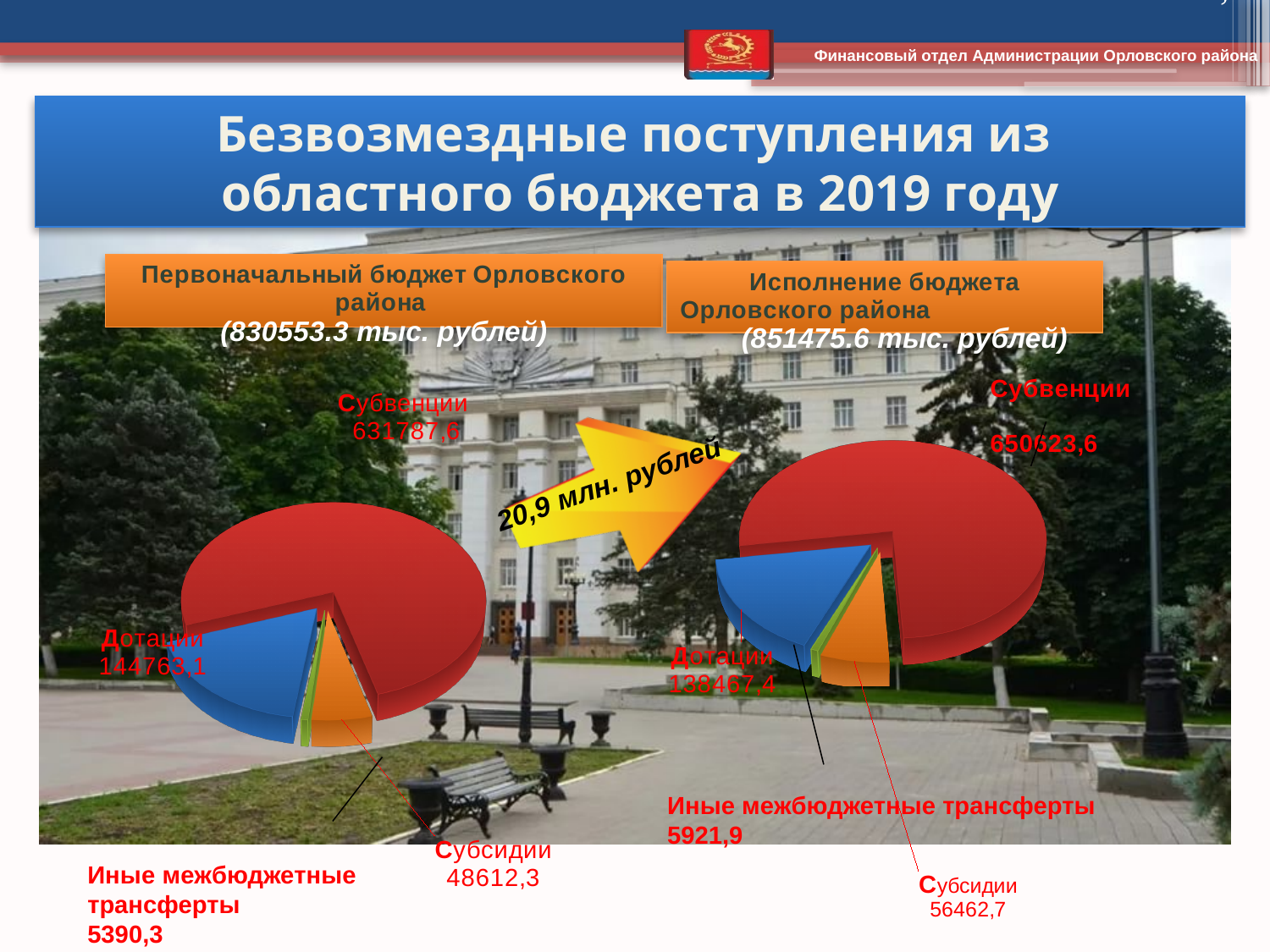
In the right chart (Исполнение бюджета Орловского района), what is the value for Иные межбюджетные трансферты? 5921,9 In the left chart (Первоначальный бюджет Орловского района), what is the value for Субсидии? 48612,3 In the right chart (Исполнение бюджета Орловского района), which category has the largest slice? Субвенции What type of chart is used on the left for the initial budget of Orlovsky district? Pie chart In the left chart (Первоначальный бюджет Орловского района), what is the value for Субвенции? 631787,6 What total amount is shown in the header of the right chart (Исполнение бюджета Орловского района)? 851475.6 тыс. рублей In the left chart (Первоначальный бюджет Орловского района), which category has the smallest value? Иные межбюджетные трансферты In the left chart (Первоначальный бюджет Орловского района), what is the value for Дотации? 144763,1 Which is larger: Дотации in the left chart (Первоначальный бюджет) or Дотации in the right chart (Исполнение бюджета)? Left chart (Первоначальный бюджет), 144763,1 How many slices does the right chart (Исполнение бюджета Орловского района) have? 4 What is the difference between Субсидии in the right chart (56462,7) and Субсидии in the left chart (48612,3)? 7850,4 In the right chart (Исполнение бюджета Орловского района), what is the value for Субсидии? 56462,7